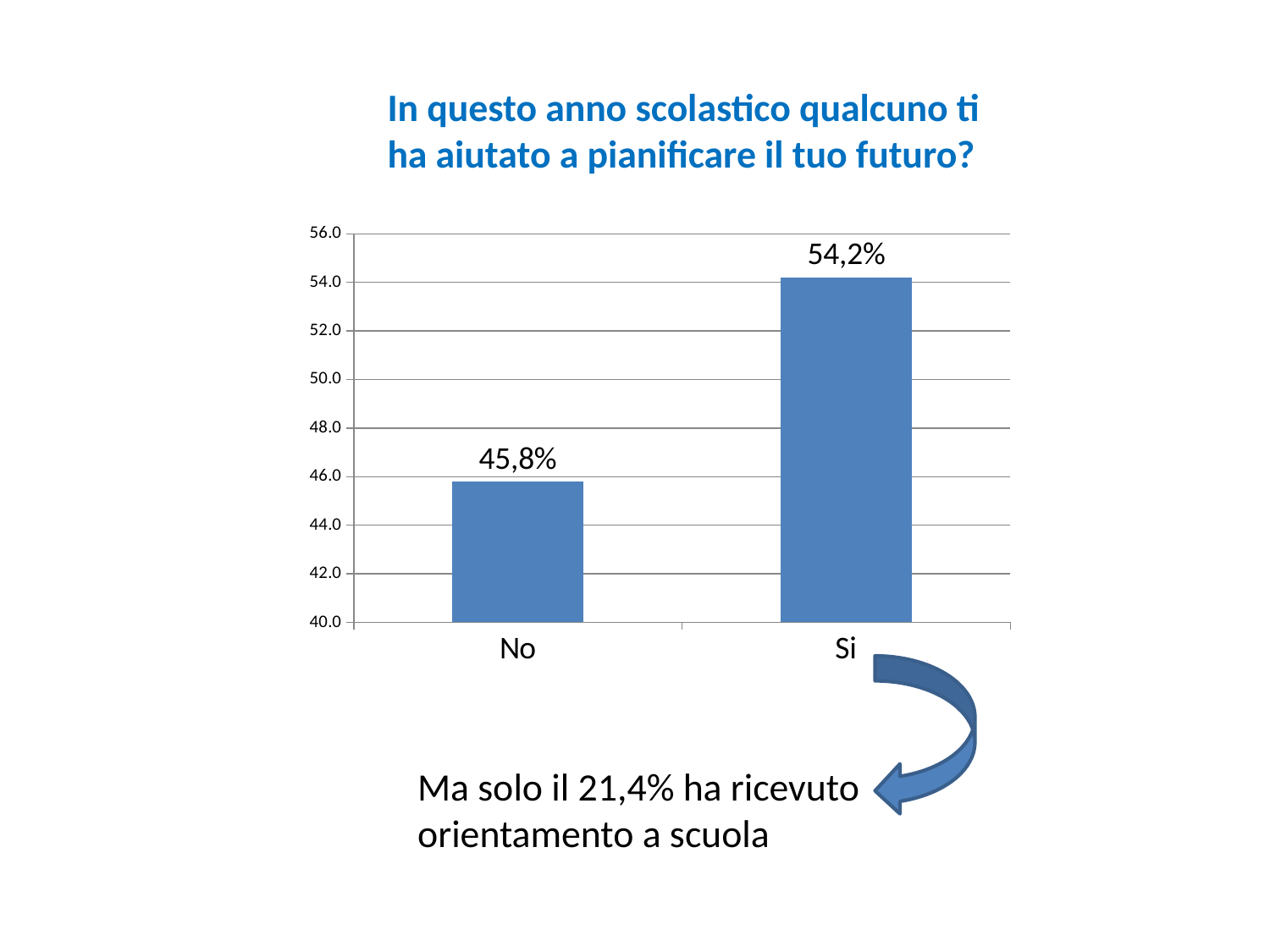
What is the title of the chart? In questo anno scolastico qualcuno ti ha aiutato a pianificare il tuo futuro? What is the highest value shown on the y axis? 56.0 Is the value for "No" greater or less than 48.0? less What kind of chart is shown on the slide? bar chart Is the value for "Si" greater or less than 52.0? greater What is the difference between the values for "Si" and "No"? 8,4% Which category has the highest value? Si What is the value for "Si"? 54,2% What is the value for "No"? 45,8% Which is larger, the value for "No" or the value for "Si"? Si Which category has the lowest value? No How many categories are shown on the x axis? 2